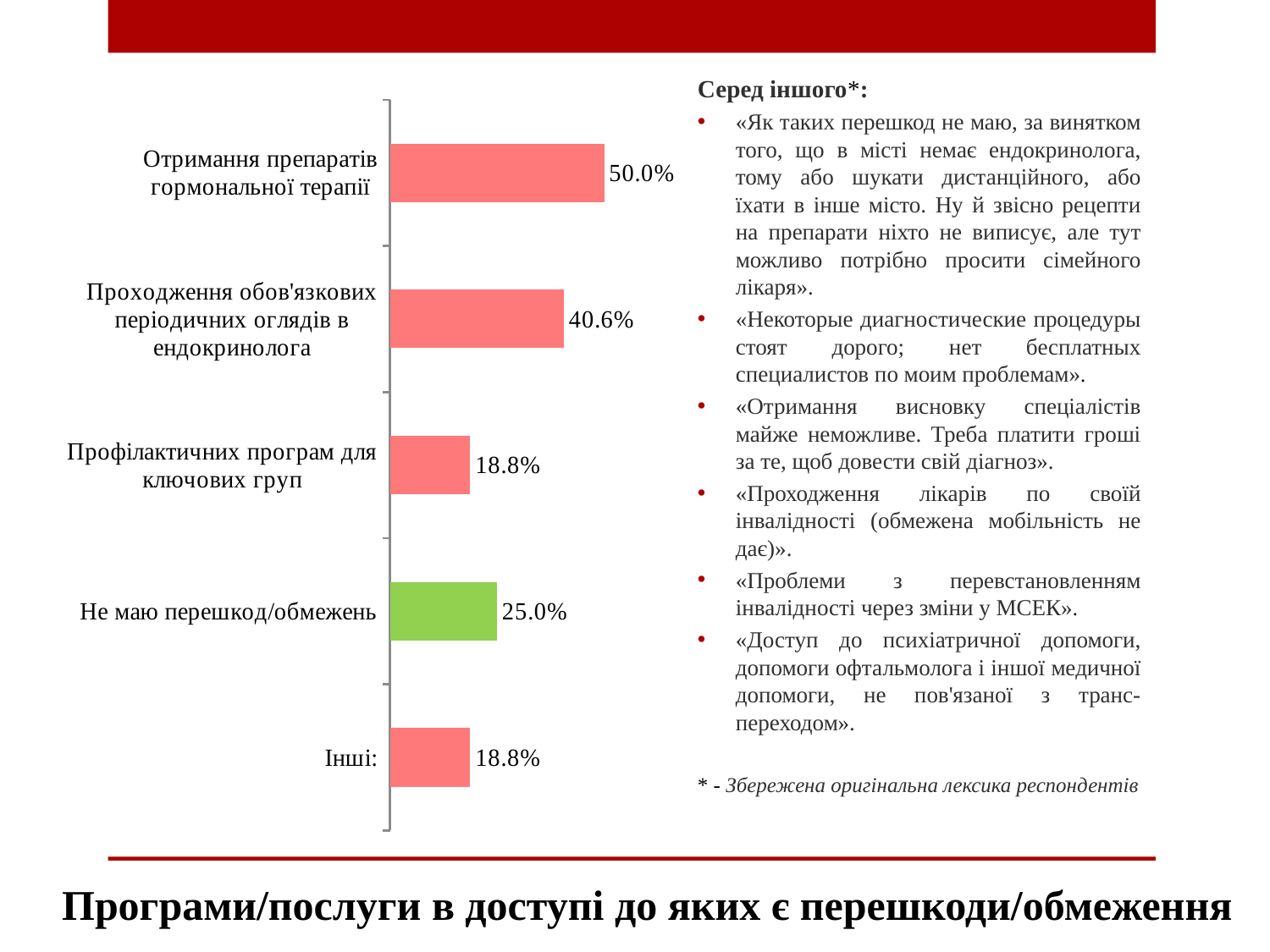
What is the difference between the values for "Отримання препаратів гормональної терапії" and "Проходження обов'язкових періодичних оглядів в ендокринолога"? 9.4% What value is shown for "Не маю перешкод/обмежень"? 25.0% What value is shown for "Інші:"? 18.8% What is the difference between the values for "Не маю перешкод/обмежень" and "Інші:"? 6.2% What value is shown for "Профілактичних програм для ключових груп"? 18.8% How many categories are shown in the chart? 5 What value is shown for "Отримання препаратів гормональної терапії"? 50.0% Which bar in the chart is coloured green rather than pink? Не маю перешкод/обмежень Which is larger: the value for "Не маю перешкод/обмежень" or the value for "Профілактичних програм для ключових груп"? Не маю перешкод/обмежень What value is shown for "Проходження обов'язкових періодичних оглядів в ендокринолога"? 40.6% What type of chart is shown on the slide? Bar chart Which category has the highest value in the chart? Отримання препаратів гормональної терапії